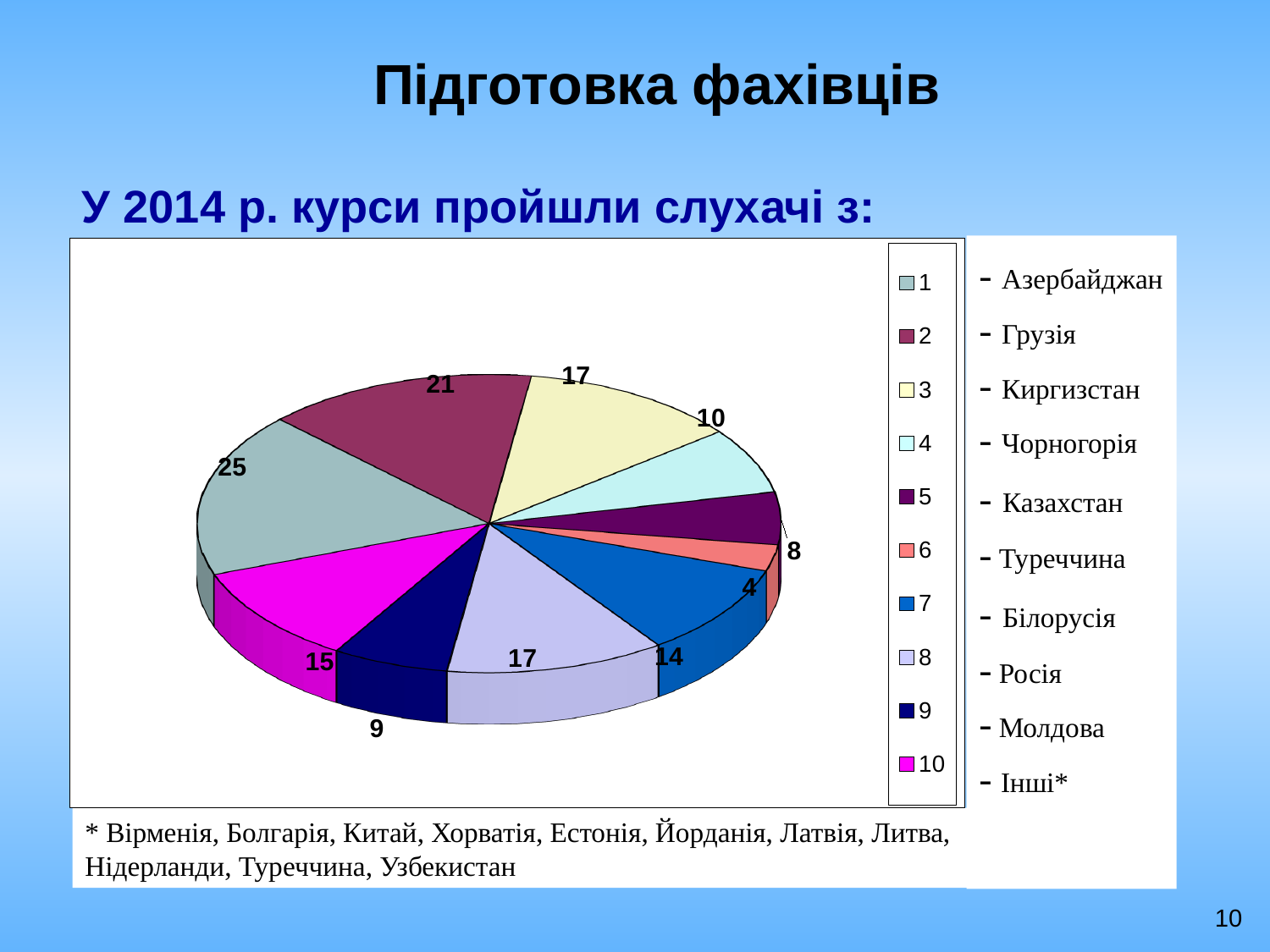
How many slices does the pie chart have? 10 What is the value for slice 7 (Білорусія)? 14 What type of chart is shown on the slide? pie chart Which is larger, the value for slice 4 (Чорногорія) or slice 5 (Казахстан)? slice 4 (Чорногорія) Which slice has the smallest value? 6 (Туреччина) Which slice has the largest value? 1 (Азербайджан) What share of the pie does slice 7 (Білорусія) represent? 10% What is the value for slice 10 (Інші*)? 15 How many entries does the chart legend list? 10 What is the difference between the values for slice 2 (Грузія) and slice 9 (Молдова)? 12 Which country does legend entry 8 correspond to? Росія What is the value for slice 1 (Азербайджан)? 25